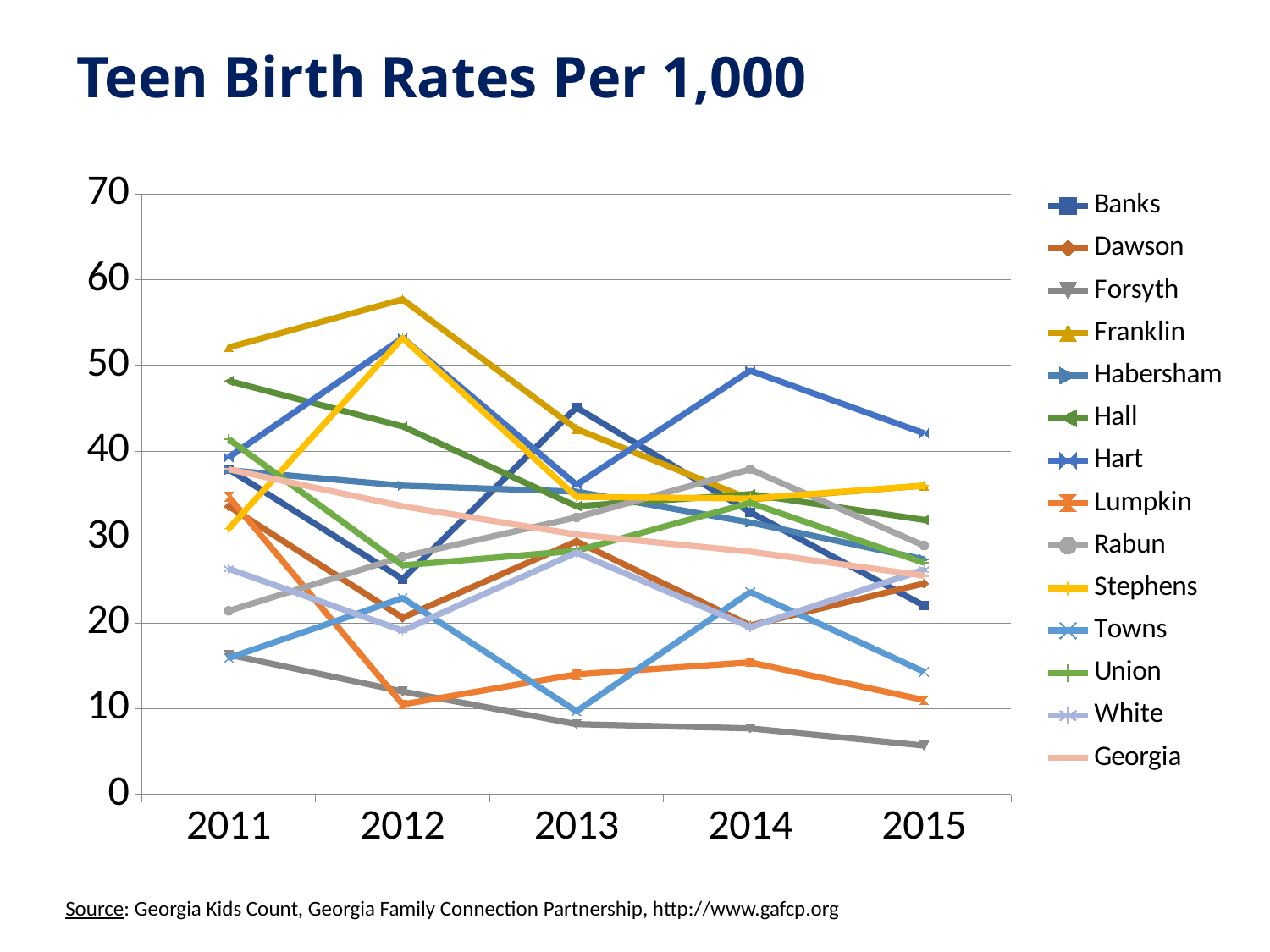
Is the value for Hart in 2014 greater or less than 40? greater What is the title of the chart? Teen Birth Rates Per 1,000 Is the value for Forsyth in 2015 greater or less than 10? less How many years are shown along the x axis? 5 In 2015, which is larger, the value for Hart or the value for Towns? Hart Is the value for Franklin in 2012 greater or less than 50? greater Which series has the lowest value in 2015? Forsyth What kind of chart is shown on the slide? line chart How many series does the legend list? 14 Does the Forsyth line rise or fall from 2011 to 2015? fall Which county has the highest value in 2012? Franklin